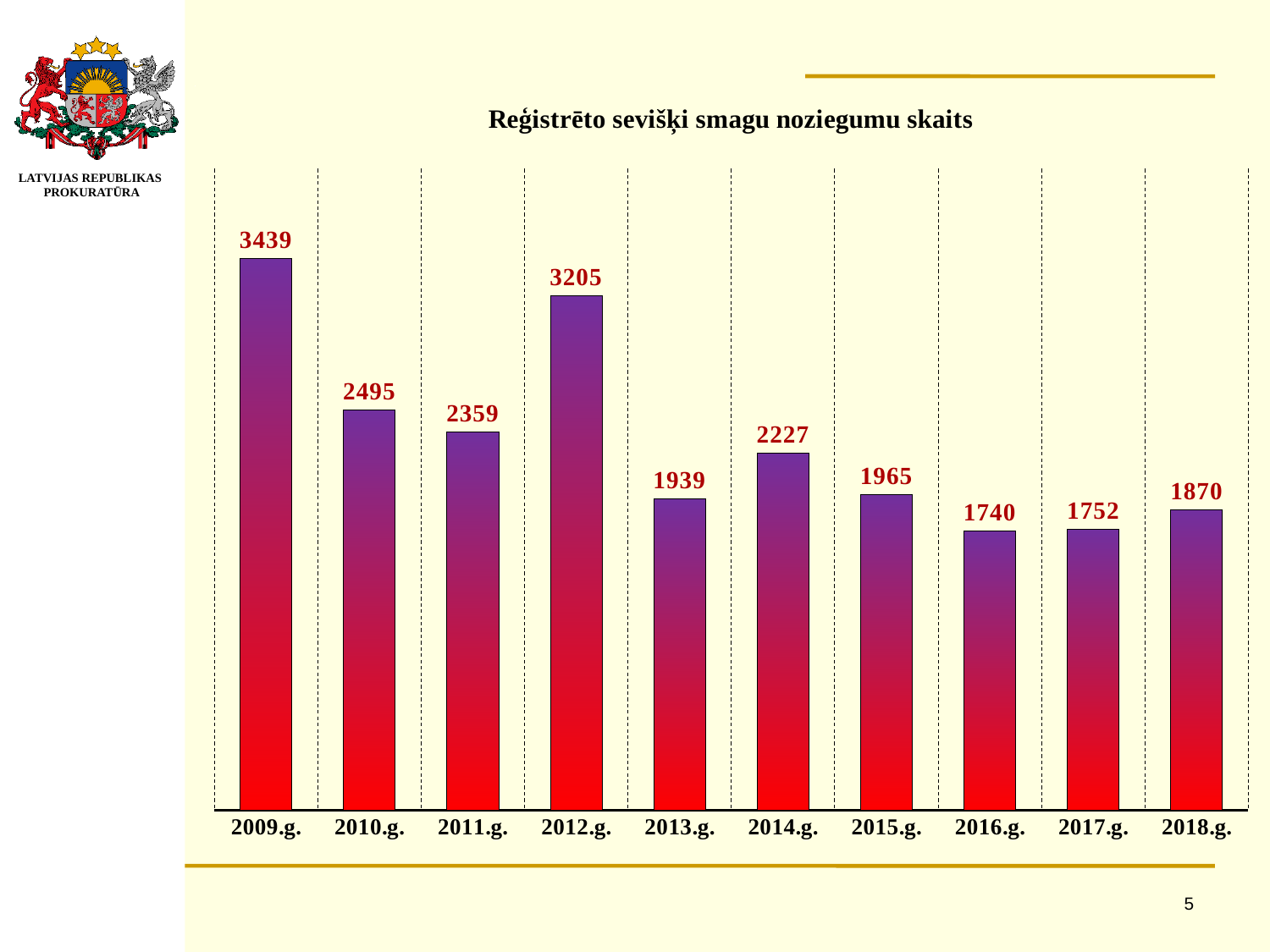
How many years are shown on the x axis? 10 Which year has the lowest value? 2016.g. What is the difference between the values for 2017.g. and 2016.g.? 12 Which year has the highest value? 2009.g. What is the value for 2009.g.? 3439 What is the value for 2014.g.? 2227 What is the difference between the values for 2009.g. and 2012.g.? 234 What kind of chart is this? bar chart What is the value for 2018.g.? 1870 What is the title of the chart? Reģistrēto sevišķi smagu noziegumu skaits Which is larger, the value for 2010.g. or the value for 2011.g.? 2010.g. Do the values generally rise or fall from 2009.g. to 2018.g.? fall